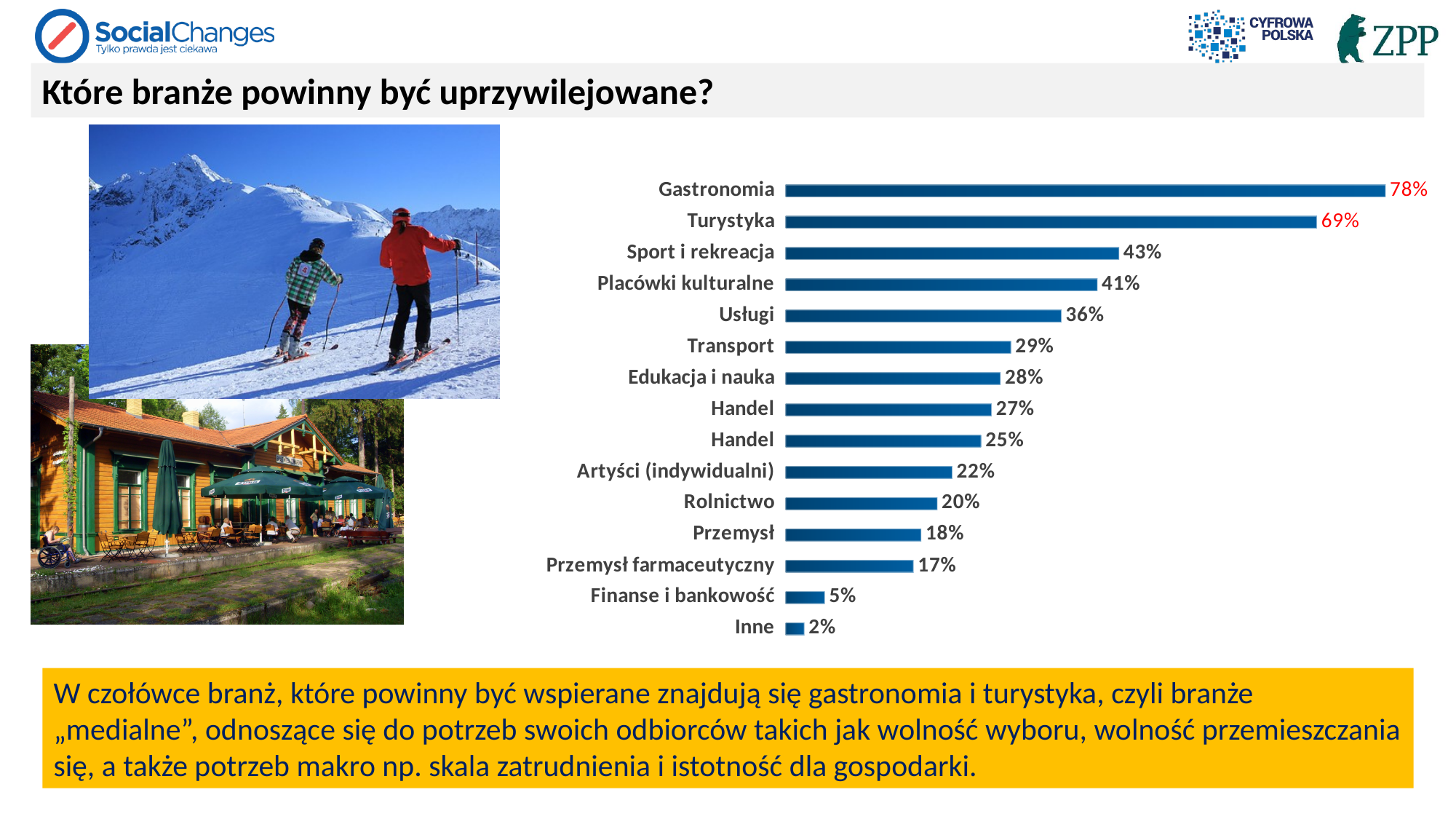
What is the difference between the values for Sport i rekreacja and Placówki kulturalne? 2% Which two categories have their data labels shown in red? Gastronomia and Turystyka Which is larger, the value for Transport or the value for Rolnictwo? Transport How many categories are shown in the chart? 15 What is the value for Turystyka? 69% What is the value for Gastronomia? 78% Which category has the lowest value? Inne What kind of chart is shown on the slide? bar chart Which category has the highest value? Gastronomia What is the value for Finanse i bankowość? 5% What is the value for Usługi? 36% What is the difference between the values for Gastronomia and Turystyka? 9%